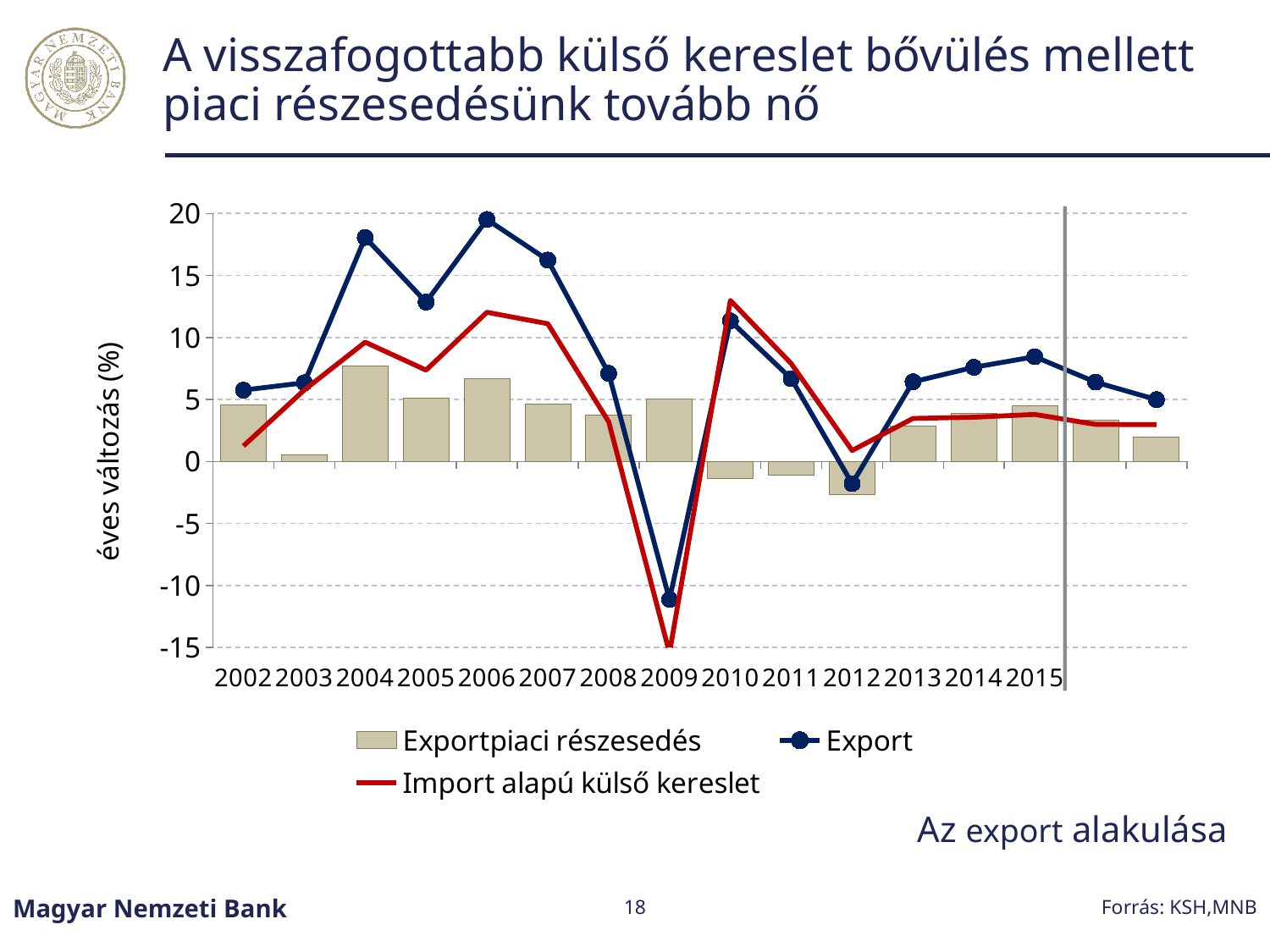
Is the Import alapú külső kereslet value for 2009 greater or less than -10? less Which is larger in 2006, the Export value or the Import alapú külső kereslet value? Export In which year is the Exportpiaci részesedés bar the tallest? 2004 What is the label of the vertical axis? éves változás (%) How many series does the legend list? 3 How many years are labelled on the x axis? 14 What kind of chart is shown on the slide? A combined bar and line chart Is the Export value for 2004 greater or less than 15? greater In which year does the Export line reach its highest value? 2006 In which year does the Export line reach its lowest value? 2009 Which series is drawn as bars in the chart? Exportpiaci részesedés Does the Export line rise or fall from 2004 to 2005? Fall